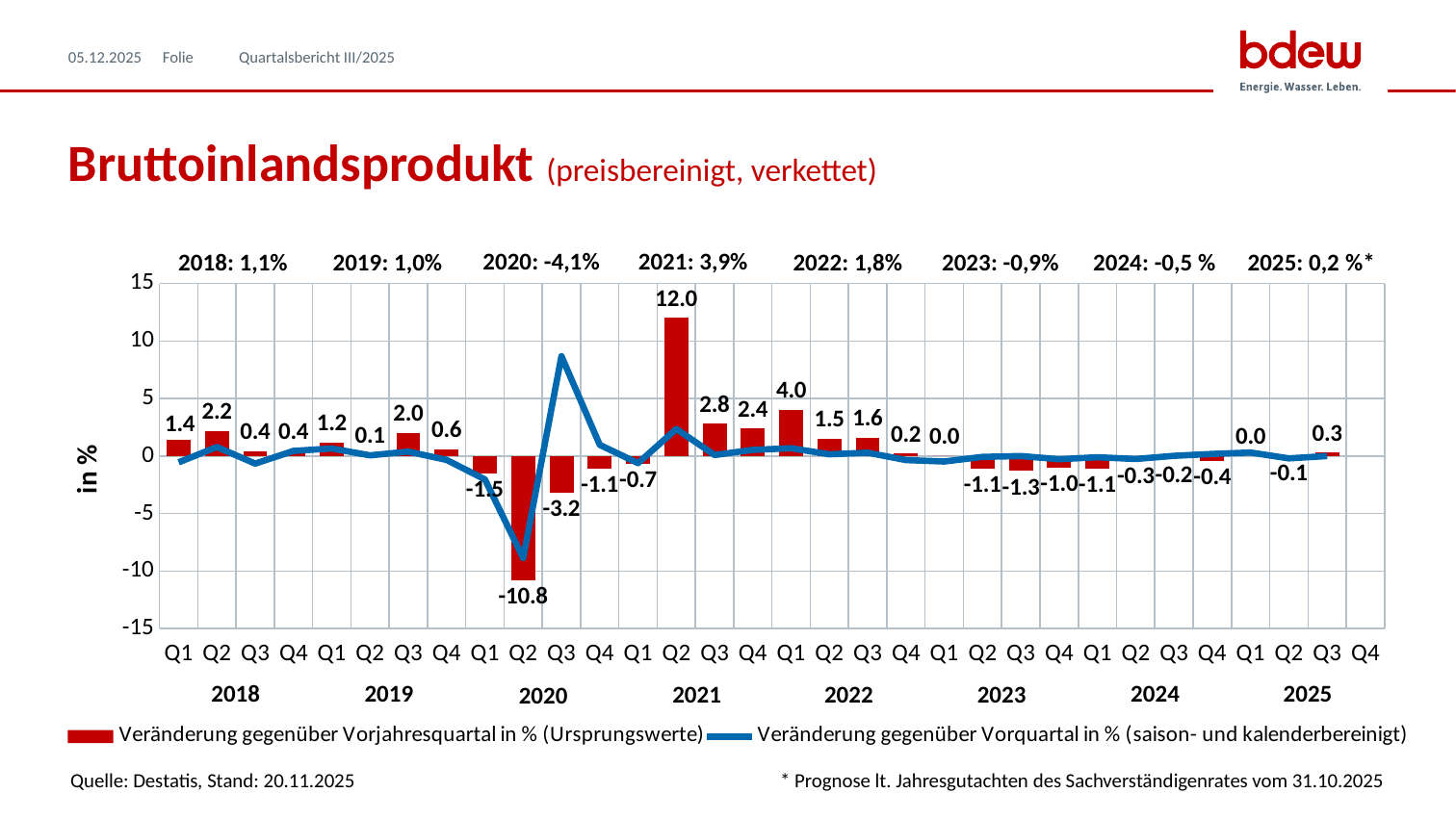
What annual value is printed above the chart for 2020? -4,1% Which red bar is larger: Q1 2022 or Q3 2021? Q1 2022 Is the blue line value for Q2 2020 greater or less than -5? less What is the label on the vertical axis? in % What is the difference between the red bar values for Q2 2021 and Q2 2020? 22.8 What is the value of the red bar (change versus the same quarter of the previous year) for Q2 2020? -10.8 What kind of chart is shown on the slide? Combined bar and line chart What is the value of the red bar for Q3 2025? 0.3 Is the blue line value for Q3 2020 greater or less than 5? greater Which quarter has the highest red bar value? Q2 2021 How many series does the legend list? 2 Which quarter has the lowest red bar value? Q2 2020